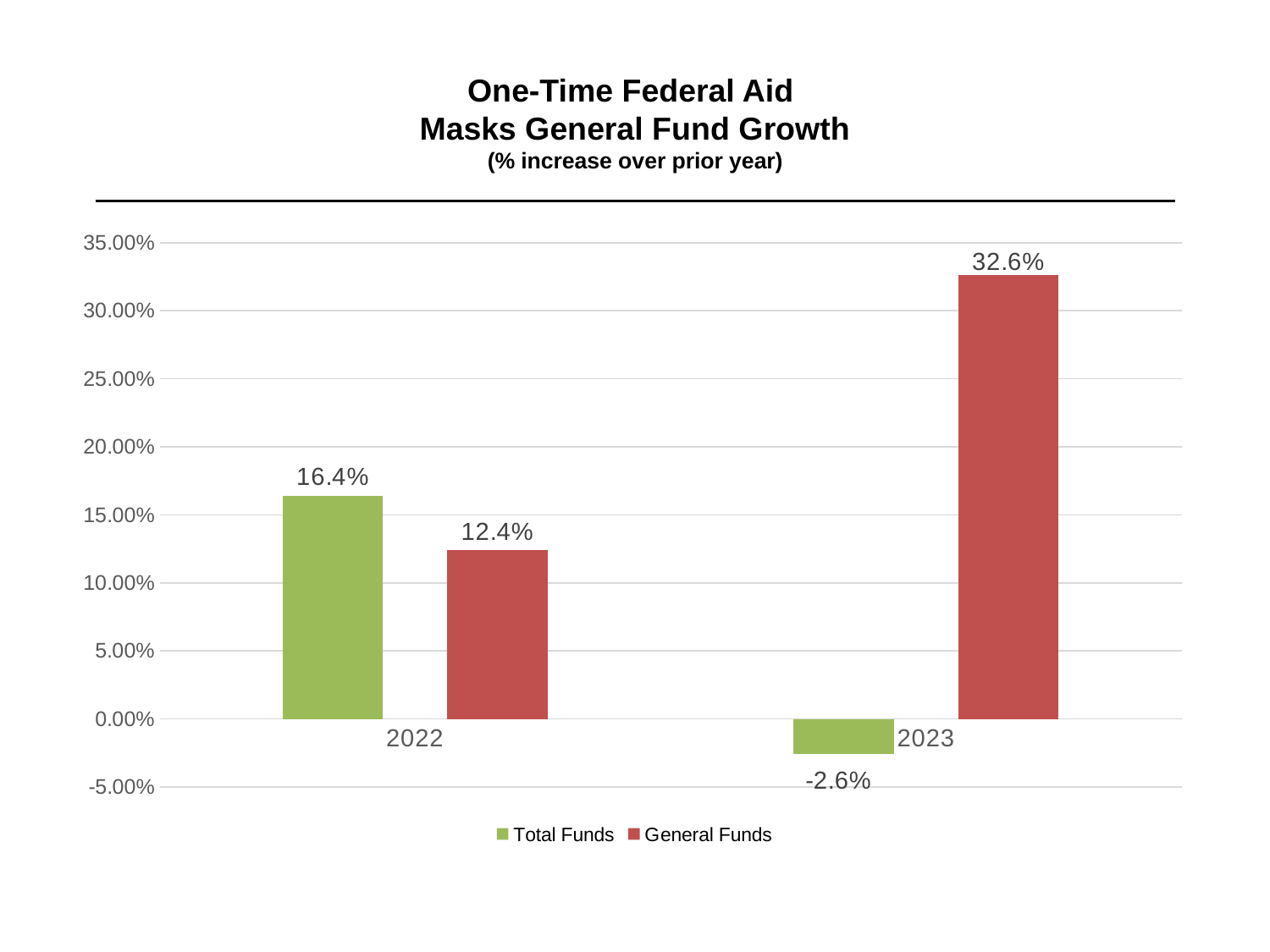
How many years are shown on the x axis? 2 Which year has the highest General Funds value? 2023 What is the difference between General Funds in 2023 and General Funds in 2022? 20.2% How many series does the legend list? 2 Is the value for General Funds in 2023 greater or less than 30.00%? greater Which year has the lowest Total Funds value? 2023 What is the value for Total Funds in 2023? -2.6% What is the value for General Funds in 2022? 12.4% What kind of chart is shown on the slide? bar chart Which is larger in 2022, Total Funds or General Funds? Total Funds What is the value for General Funds in 2023? 32.6% What is the value for Total Funds in 2022? 16.4%